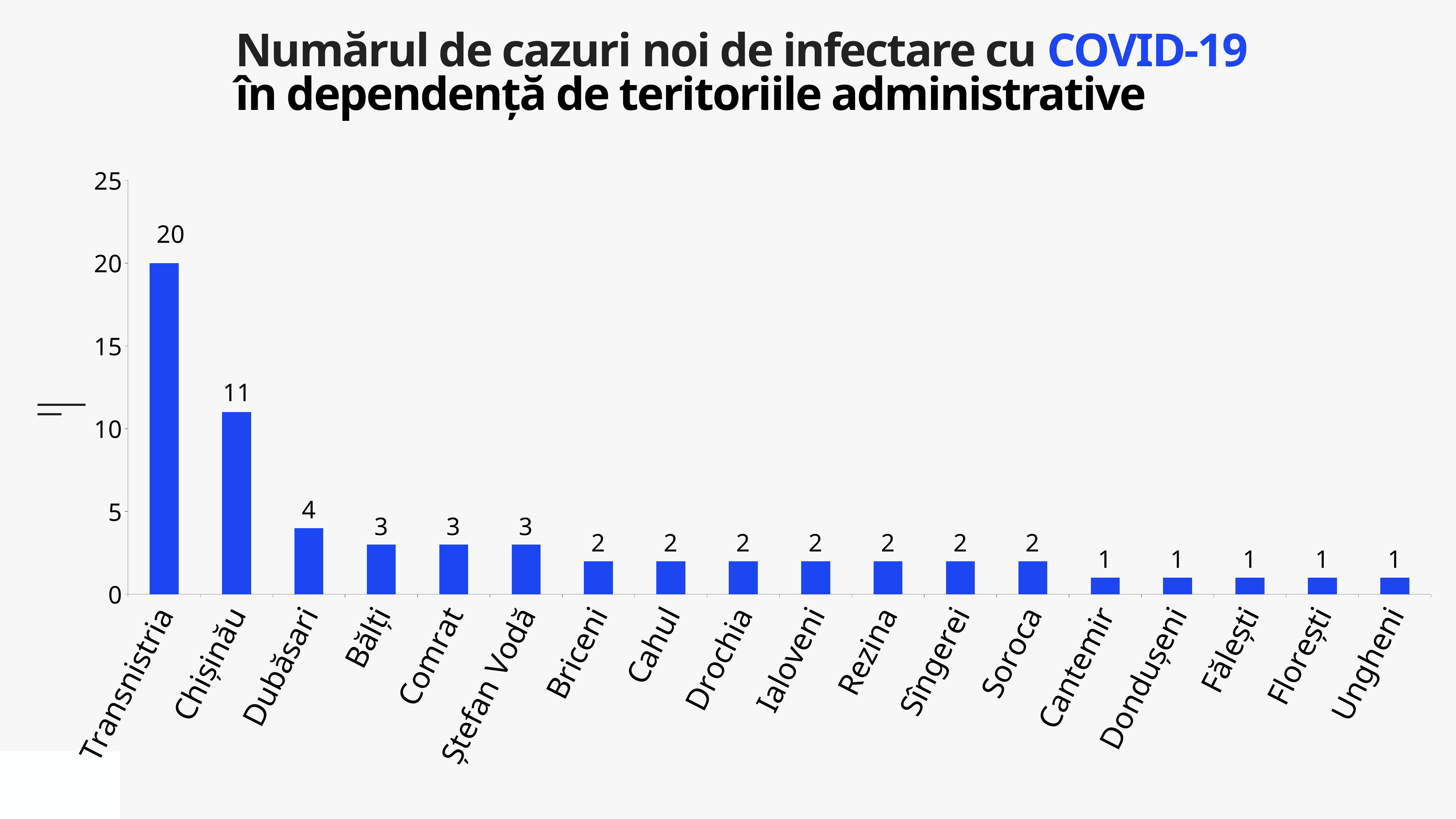
What is the value for Chișinău? 11 Which territory has the highest number of new cases? Transnistria What is the difference between the values for Dubăsari and Ungheni? 3 Is the value for Transnistria greater or less than 15? greater Do the values rise or fall from left to right along the x axis? fall How many territories are shown on the x axis? 18 What is the value for Dubăsari? 4 What kind of chart is shown on the slide? bar chart What is the value for Soroca? 2 What is the difference between the values for Transnistria and Chișinău? 9 What is the value for Transnistria? 20 Which is larger, the value for Chișinău or the value for Bălți? Chișinău